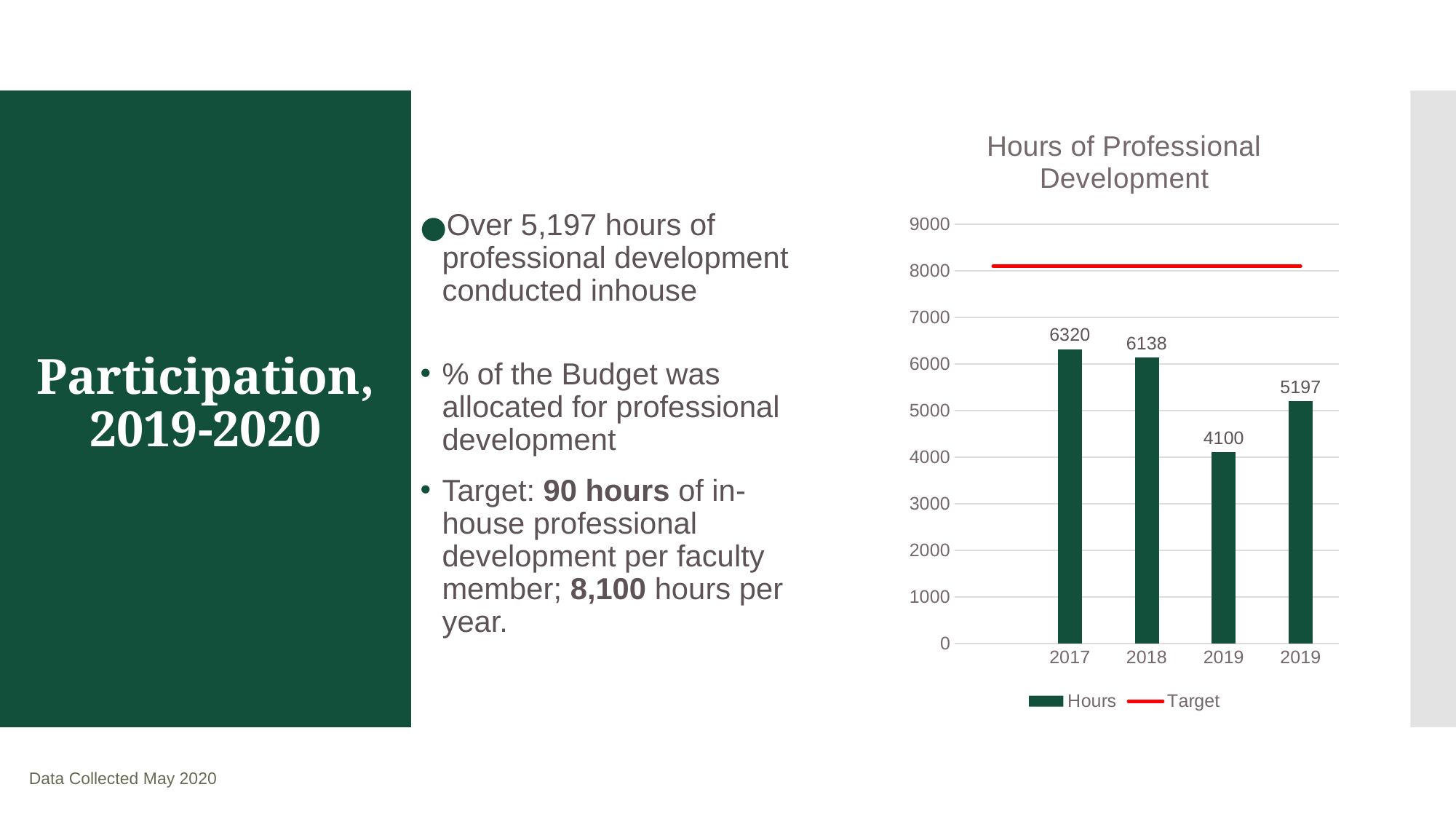
What is the value of the Hours bar for 2018? 6138 How many series does the legend list? 2 Is the red Target line greater or less than 9000? less What is the lowest value shown on any bar in the chart? 4100 How many bars are plotted in the chart? 4 Which is larger, the 2018 bar or the rightmost bar? 2018 What is the difference between the 2017 bar and the 2018 bar? 182 What is the value of the Hours bar for 2017 in the Hours of Professional Development chart? 6320 Which year has the highest Hours bar? 2017 What type of chart is used to show the Hours data? bar chart What is the difference between the highest bar (6320) and the lowest bar (4100)? 2220 What is the value of the rightmost bar in the chart? 5197